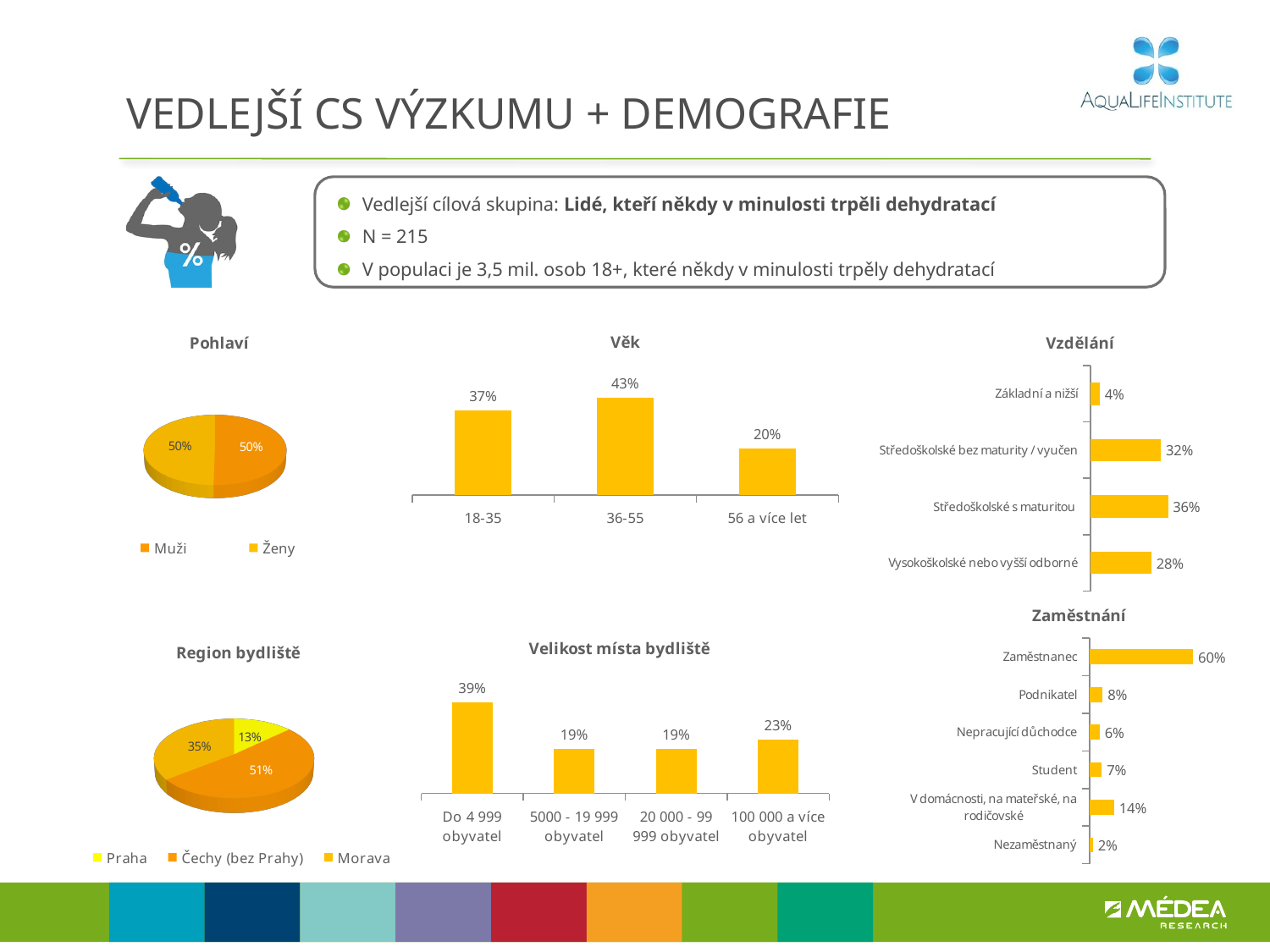
In the 'Věk' chart, what is the value for the 36-55 category? 43% In the 'Zaměstnání' chart, what is the value for 'V domácnosti, na mateřské, na rodičovské'? 14% What type of chart is the 'Pohlaví' chart? Pie chart In the 'Zaměstnání' chart, which category has the highest value? Zaměstnanec In the 'Velikost místa bydliště' chart, what is the value for 'Do 4 999 obyvatel'? 39% In the 'Vzdělání' chart, what is the value for 'Středoškolské s maturitou'? 36% How many entries does the legend of the 'Region bydliště' chart list? 3 In the 'Věk' chart, which age category has the lowest value? 56 a více let How many categories does the 'Zaměstnání' chart show? 6 In the 'Region bydliště' chart, what share does Praha have? 13% In the 'Vzdělání' chart, what is the difference between 'Středoškolské bez maturity / vyučen' and 'Základní a nižší'? 28% In the 'Velikost místa bydliště' chart, which is larger: '100 000 a více obyvatel' or '5000 - 19 999 obyvatel'? 100 000 a více obyvatel